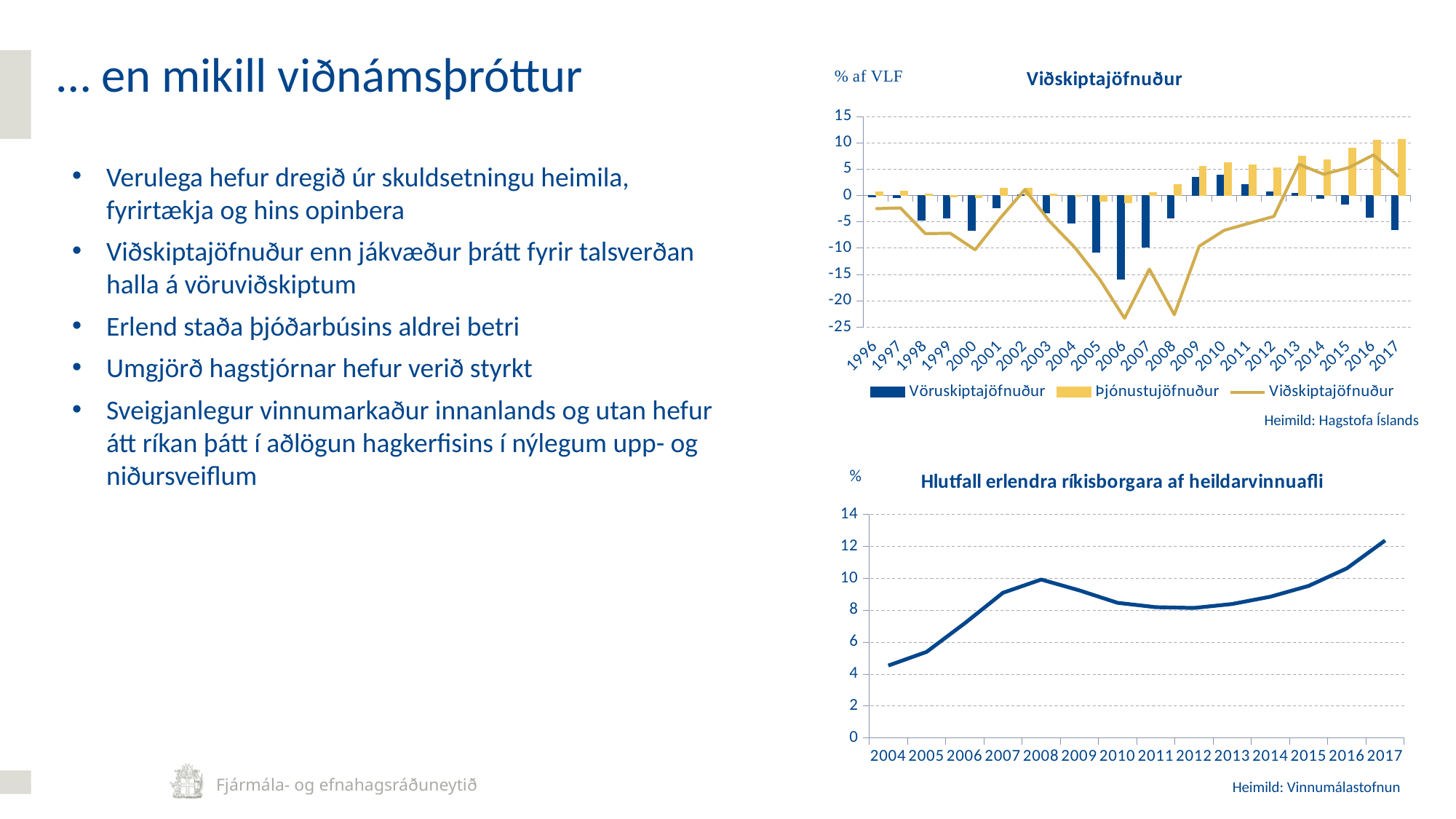
How many years are shown on the x axis of the top chart 'Viðskiptajöfnuður'? 22 In the top chart 'Viðskiptajöfnuður', which year has the lowest Vöruskiptajöfnuður bar? 2006 What kind of chart is the bottom chart, 'Hlutfall erlendra ríkisborgara af heildarvinnuafli'? line chart How many series does the legend of the top chart 'Viðskiptajöfnuður' list? 3 In the bottom chart 'Hlutfall erlendra ríkisborgara af heildarvinnuafli', which year has the highest value? 2017 In the bottom chart 'Hlutfall erlendra ríkisborgara af heildarvinnuafli', is the value for 2008 larger or the value for 2012? 2008 What is the unit label shown above the y axis of the top chart 'Viðskiptajöfnuður'? % af VLF In the top chart 'Viðskiptajöfnuður', is the Vöruskiptajöfnuður value for 2006 greater or less than -10? less In the bottom chart 'Hlutfall erlendra ríkisborgara af heildarvinnuafli', which year has the lowest value? 2004 How many years are shown on the x axis of the bottom chart 'Hlutfall erlendra ríkisborgara af heildarvinnuafli'? 14 In the bottom chart 'Hlutfall erlendra ríkisborgara af heildarvinnuafli', is the value for 2004 greater or less than 6? less In the top chart 'Viðskiptajöfnuður', is the Viðskiptajöfnuður line value for 2006 greater or less than -20? less